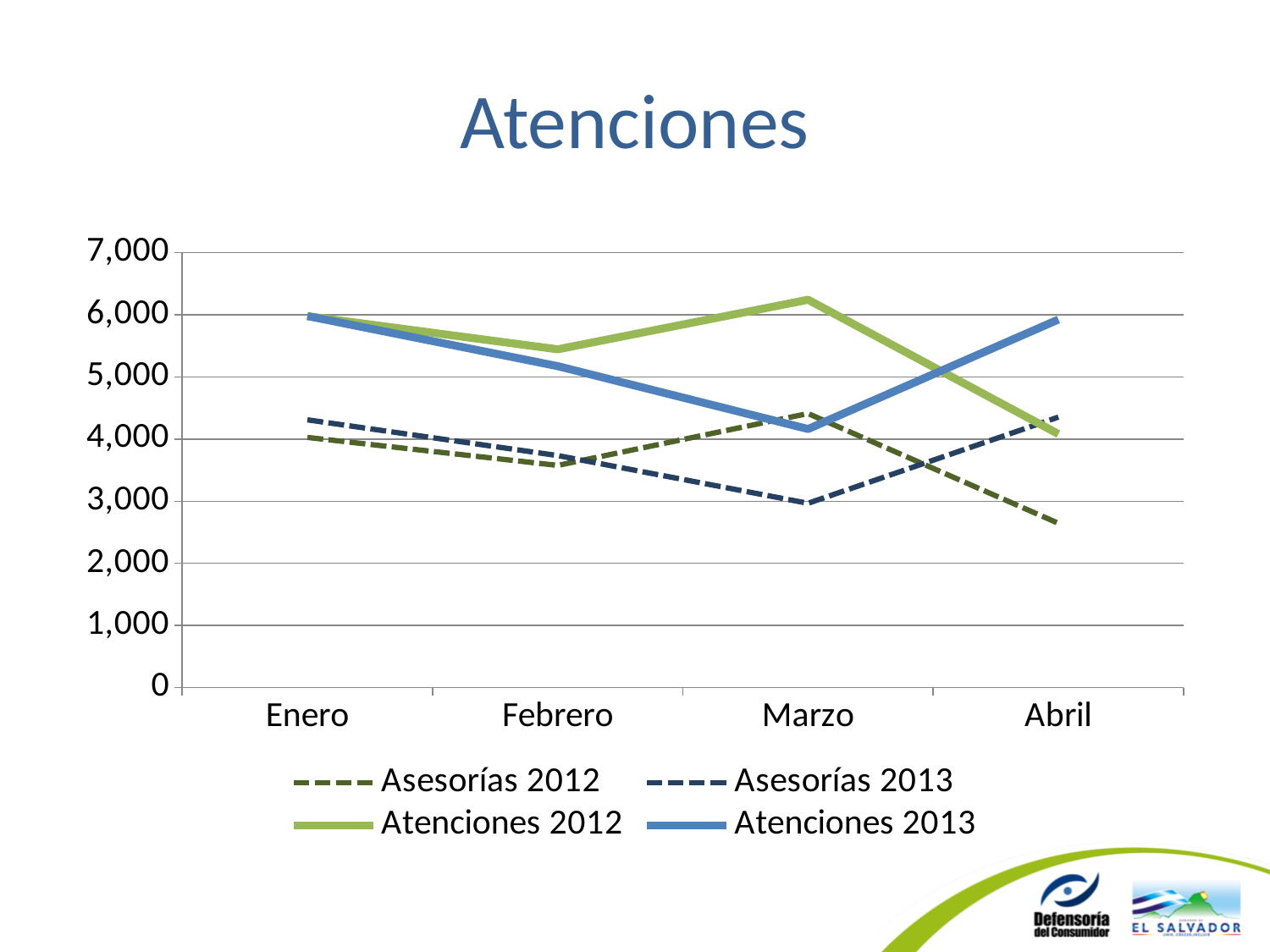
In which month is Atenciones 2013 lowest? Marzo What kind of chart is shown on the slide? Line chart In Abril, which is larger: Atenciones 2012 or Atenciones 2013? Atenciones 2013 How many months are shown on the x axis? 4 Is the value for Atenciones 2012 in Marzo greater or less than 6,000? greater Is the value for Asesorías 2012 in Abril greater or less than 3,000? less Is the value for Atenciones 2013 in Marzo greater or less than 5,000? less In which month is Asesorías 2012 lowest? Abril In which month is Atenciones 2012 highest? Marzo How many series does the legend list? 4 Does Asesorías 2013 rise or fall from Enero to Marzo? Fall In Marzo, which is larger: Asesorías 2012 or Asesorías 2013? Asesorías 2012